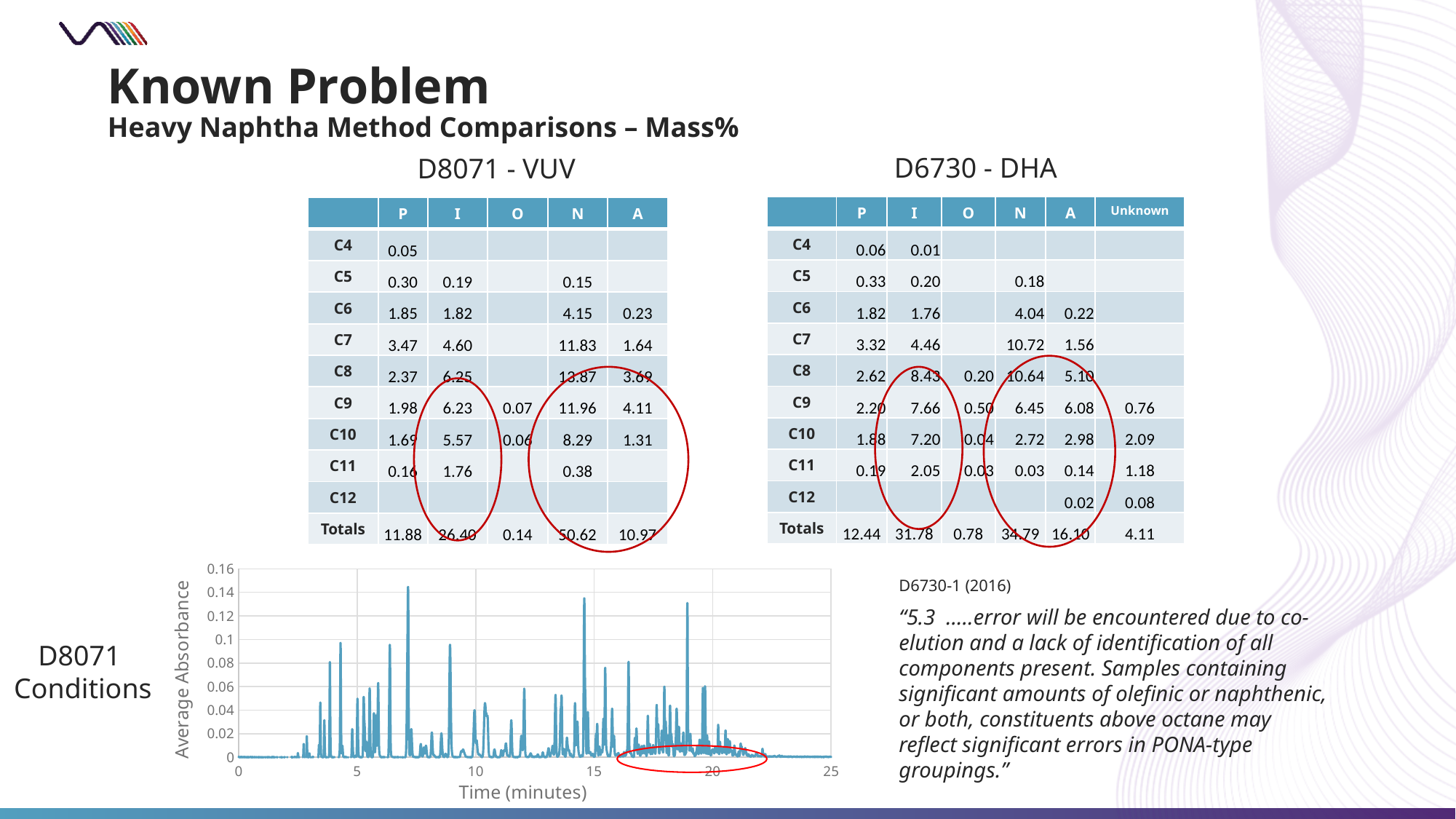
In the chromatogram chart, is the tallest peak greater or less than 0.12 on the Average Absorbance axis? greater In the chromatogram chart, is the peak near 2.5 minutes greater or less than 0.04? less What is the title of the x axis of the chromatogram chart? Time (minutes) In the chromatogram chart, is the absorbance after 23 minutes greater or less than 0.02? less In the chromatogram chart, does the tallest peak occur before or after 10 minutes? before What is the highest tick value shown on the Average Absorbance axis of the chromatogram chart? 0.16 How many data series are plotted in the chromatogram chart? 1 What kind of chart is shown at the bottom of the slide? line chart What is the title of the y axis of the chromatogram chart? Average Absorbance What is the highest tick value shown on the Time (minutes) axis of the chromatogram chart? 25